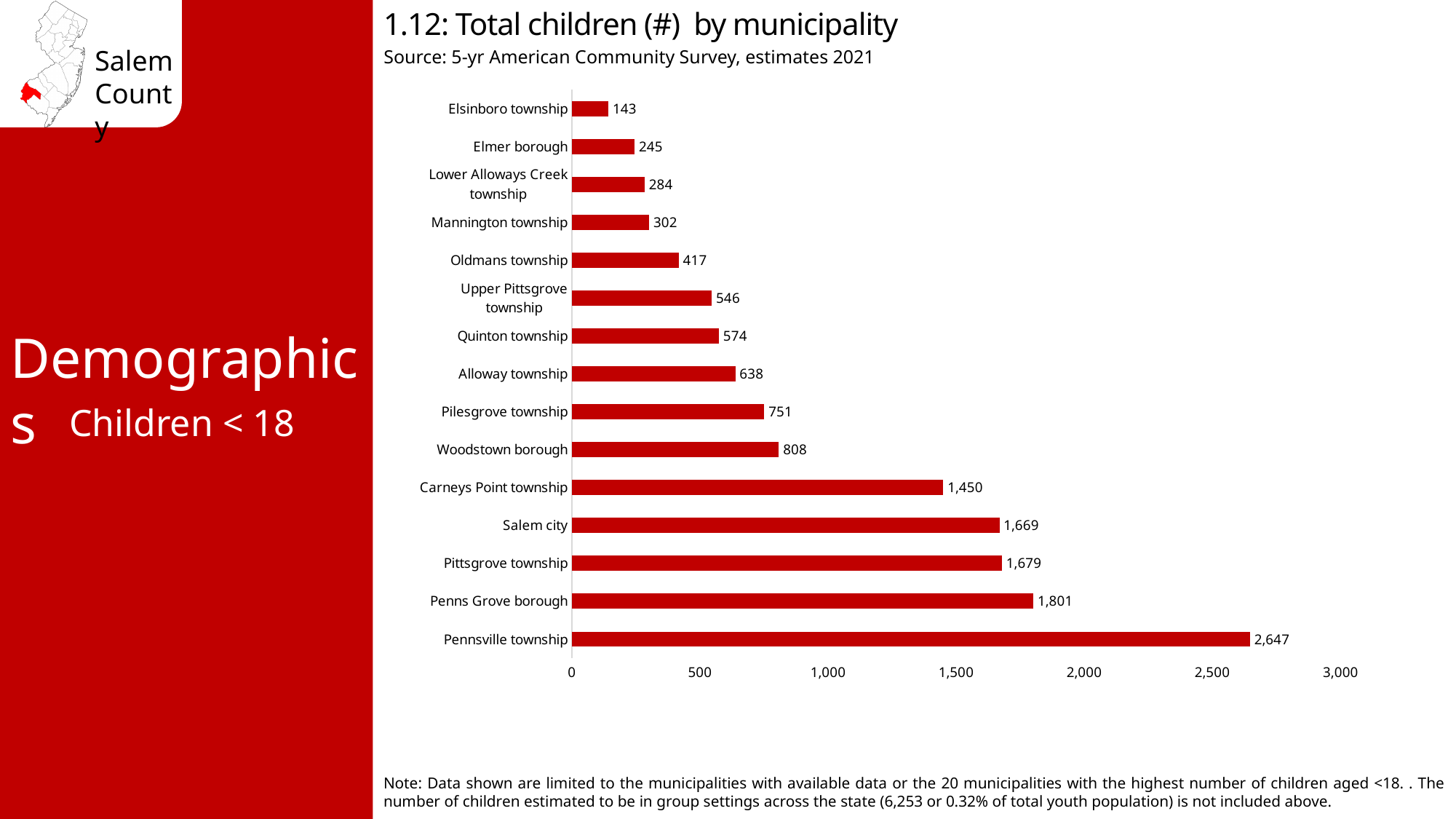
Which municipality has the highest number of children? Pennsville township What is the total number of children in Pennsville township? 2,647 What is the total number of children in Oldmans township? 417 What is the difference in the number of children between Penns Grove borough and Carneys Point township? 351 Which municipality has the lowest number of children? Elsinboro township What is the difference in the number of children between Pennsville township and Elsinboro township? 2,504 Is the value for Carneys Point township greater or less than 1,500? less What type of chart is shown on the slide? Bar chart Which has more children, Alloway township or Quinton township? Alloway township What is the total number of children in Woodstown borough? 808 How many municipalities are shown in the chart? 15 What is the source of the data shown in the chart? 5-yr American Community Survey, estimates 2021